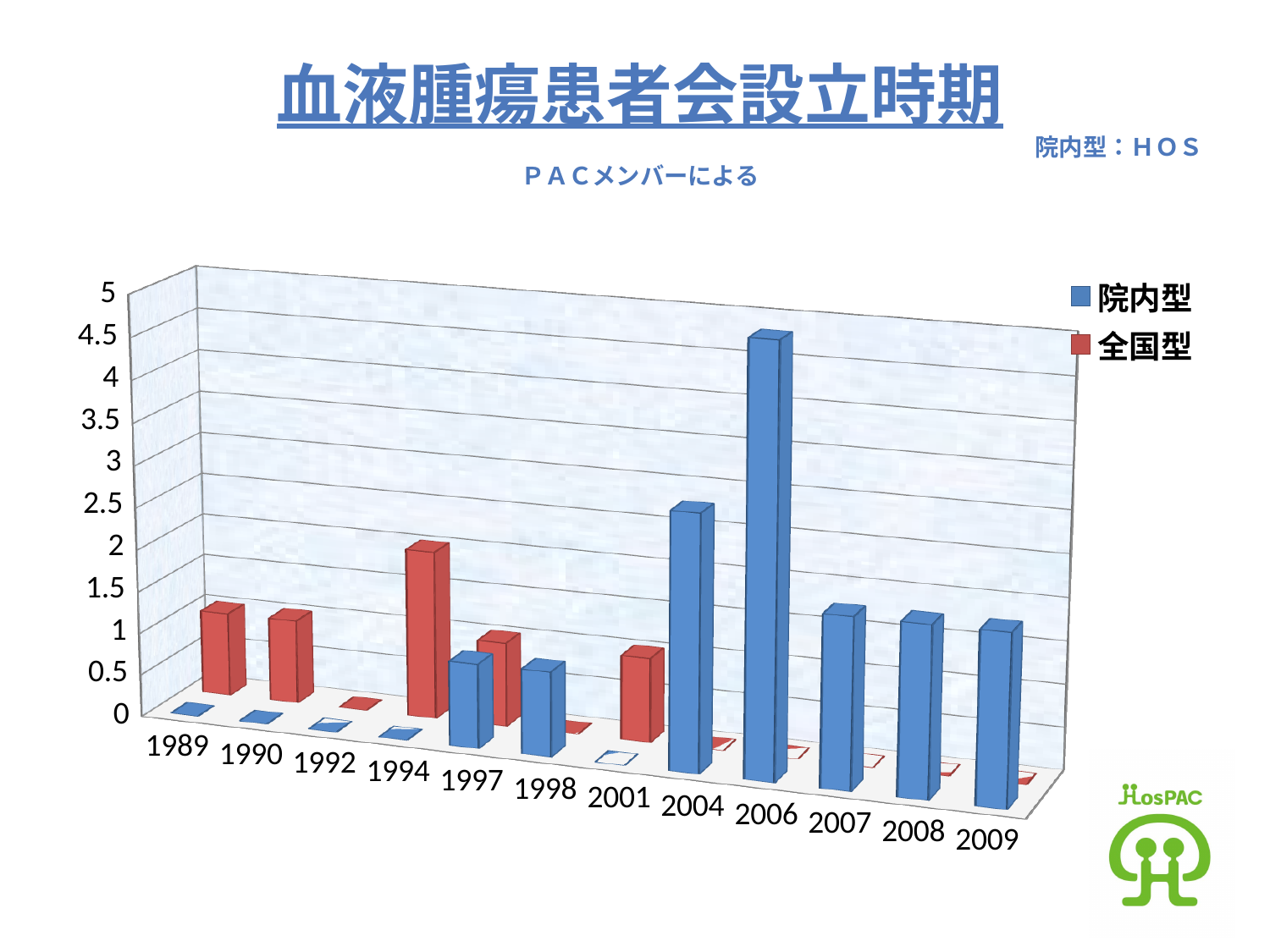
In which year is the 全国型 value highest? 1994 Is the 院内型 value for 2004 greater or less than 2? greater Is the 院内型 value for 2006 greater or less than 4? greater How many series does the legend list? 2 How many year categories are shown on the x axis? 12 In which year is the 院内型 value highest? 2006 Which is larger, the 全国型 value for 1994 or for 1990? 1994 What kind of chart is shown on the slide? bar chart Is the 全国型 value for 1994 greater or less than 1? greater Which is larger, the 院内型 value for 2004 or for 2007? 2004 Which colour represents the 院内型 series? blue